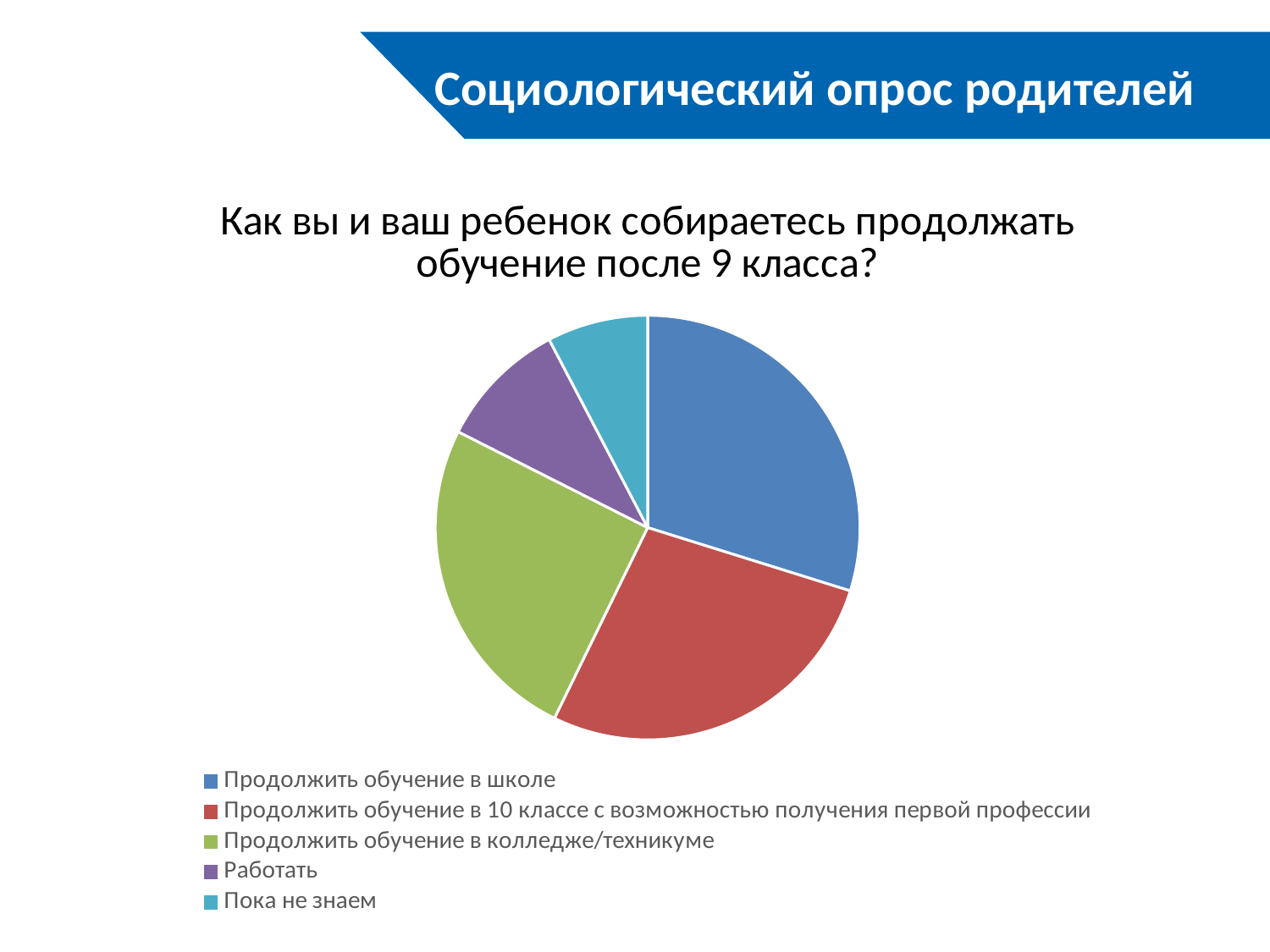
Which slice is larger: "Продолжить обучение в 10 классе с возможностью получения первой профессии" or "Пока не знаем"? Продолжить обучение в 10 классе с возможностью получения первой профессии Which category has the smallest slice in the pie chart? Пока не знаем Which slice is larger: "Продолжить обучение в колледже/техникуме" or "Работать"? Продолжить обучение в колледже/техникуме What kind of chart is shown on the slide? pie chart What colour is the "Работать" slice in the pie chart? purple What is the title of the pie chart? Как вы и ваш ребенок собираетесь продолжать обучение после 9 класса? How many entries does the legend of the pie chart list? 5 Which slice is larger: "Работать" or "Пока не знаем"? Работать How many slices does the pie chart have? 5